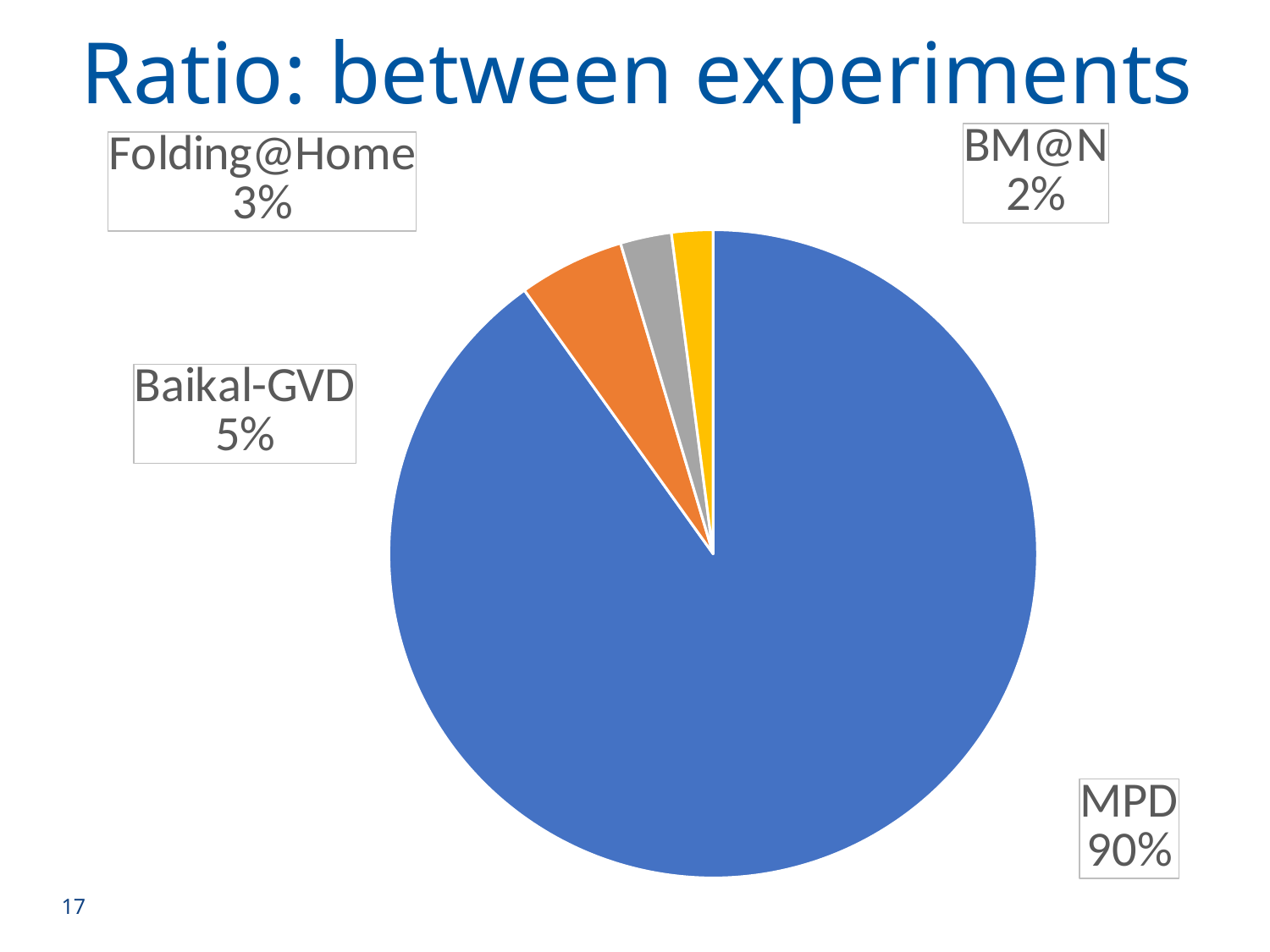
How many slices does the pie chart have? 4 What share of the pie does BM@N have? 2% What is the difference in percentage points between the MPD share and the Baikal-GVD share? 85 What kind of chart is shown on the slide? Pie chart Which experiment has the smallest share of the pie? BM@N Which has a larger share, Baikal-GVD or Folding@Home? Baikal-GVD Which experiment has the largest share of the pie? MPD What is the title of the slide containing the chart? Ratio: between experiments What is the difference in percentage points between the Folding@Home share and the BM@N share? 1 What share of the pie does MPD have? 90% What share of the pie does Baikal-GVD have? 5% What share of the pie does Folding@Home have? 3%